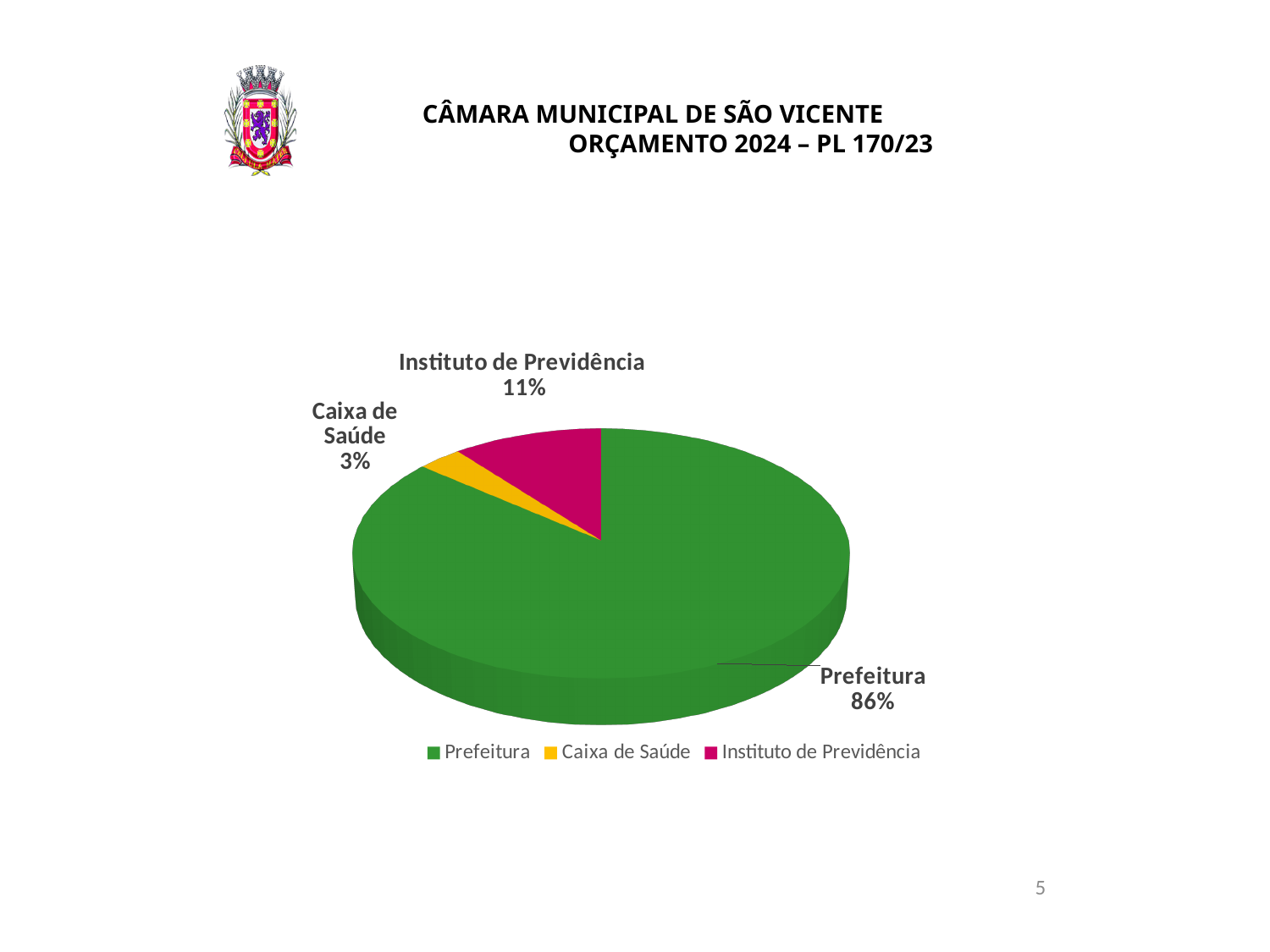
Which is larger, the share for Instituto de Previdência or the share for Caixa de Saúde? Instituto de Previdência What is the difference in percentage points between Prefeitura and Instituto de Previdência? 75 Which category has the smallest slice of the pie? Caixa de Saúde What share of the pie does Caixa de Saúde have? 3% What share of the pie does Instituto de Previdência have? 11% How many entries does the legend list? 3 What kind of chart is shown on the slide? pie chart How many slices does the pie chart have? 3 What share of the pie does Prefeitura have? 86% What is the difference in percentage points between Instituto de Previdência and Caixa de Saúde? 8 Which category has the largest slice of the pie? Prefeitura What colour is the Caixa de Saúde slice? yellow